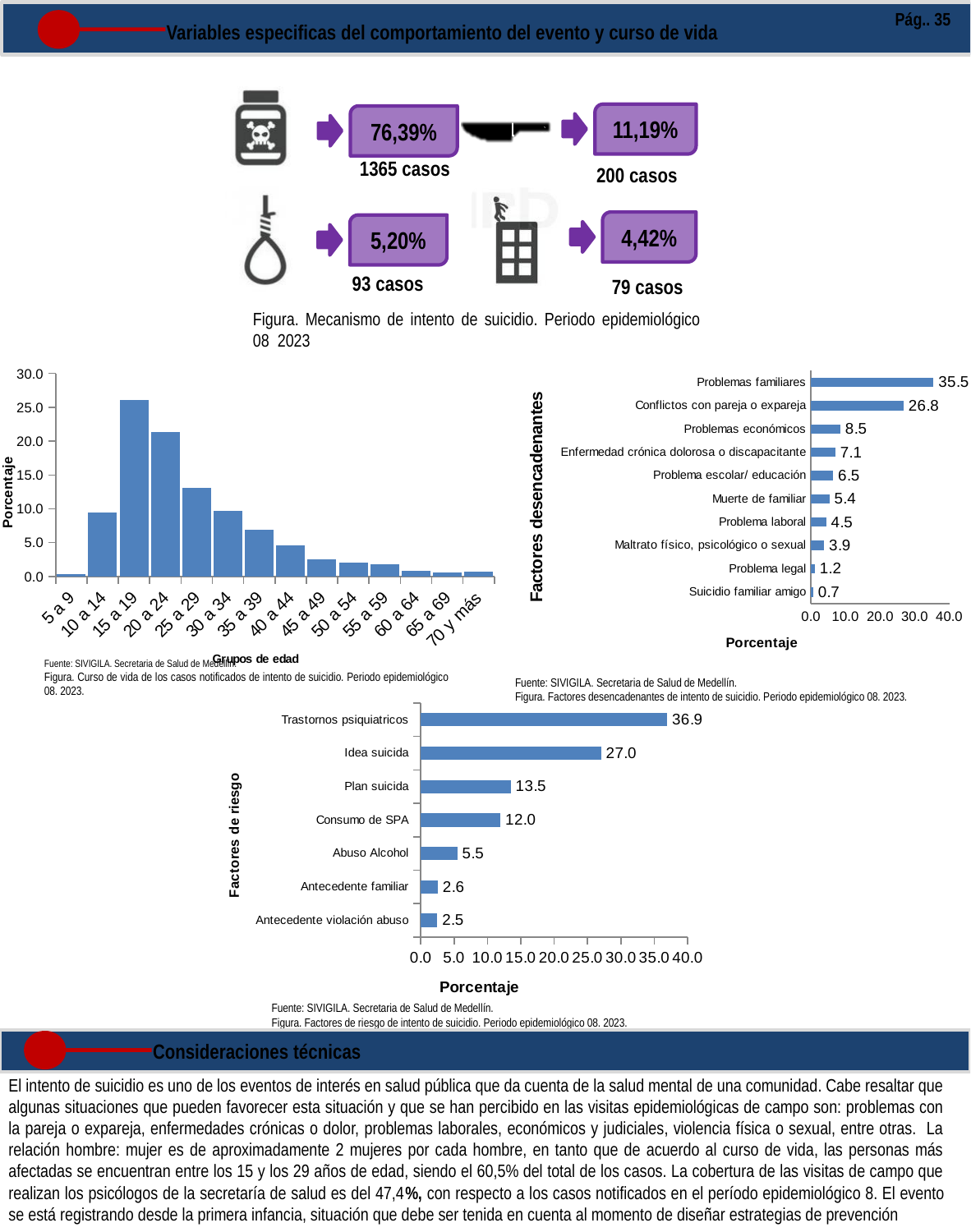
In the 'Factores de riesgo' chart, how many risk factors are shown? 7 What type of chart is the 'Factores de riesgo' chart? Bar chart In the 'Factores desencadenantes' chart, which is larger: Problemas económicos or Problema escolar/ educación? Problemas económicos In the 'Factores desencadenantes' chart, what is the difference between Problemas familiares and Conflictos con pareja o expareja? 8.7 In the 'Factores desencadenantes' chart, which factor has the lowest percentage? Suicidio familiar amigo In the 'Factores desencadenantes' chart, what is the value for Problemas familiares? 35.5 In the 'Factores de riesgo' chart, what is the value for Consumo de SPA? 12.0 In the 'Factores de riesgo' chart, which factor has the highest percentage? Trastornos psiquiatricos In the age group chart (Grupos de edad), which age group has the highest percentage? 15 a 19 In the 'Factores de riesgo' chart, what is the difference between Trastornos psiquiatricos and Idea suicida? 9.9 In the age group chart (Grupos de edad), is the value for 25 a 29 greater or less than 10.0? greater In the 'Factores desencadenantes' chart, how many factors are listed? 10